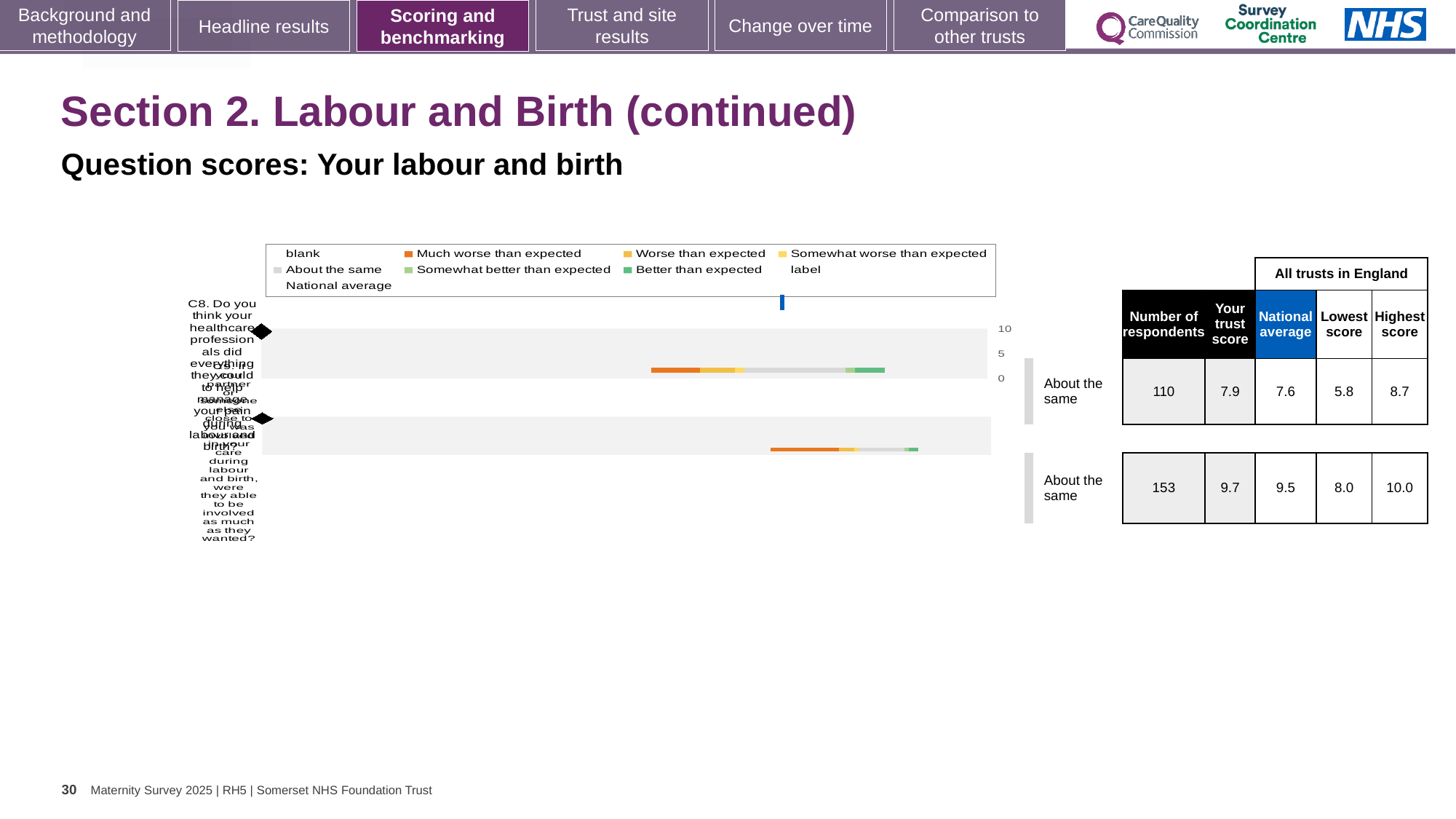
How many questions (bars) are plotted in the chart? 2 What kind of chart is shown on the slide? bar chart Which question has the higher trust score, the first (C8) or the second? the second What is the difference between the trust score and the national average for the first question (C8)? 0.3 In the table next to the chart, what is the trust score for the first question (C8)? 7.9 What colour represents 'Much worse than expected' in the chart legend? orange In the table next to the chart, what is the national average for the first question (C8)? 7.6 In the table next to the chart, what is the lowest score for the second question? 8.0 In the table next to the chart, what is the number of respondents for the first question (C8)? 110 What is the difference between the highest and lowest score for the first question (C8)? 2.9 In the table next to the chart, what is the number of respondents for the second question? 153 In the table next to the chart, what is the highest score for the second question? 10.0